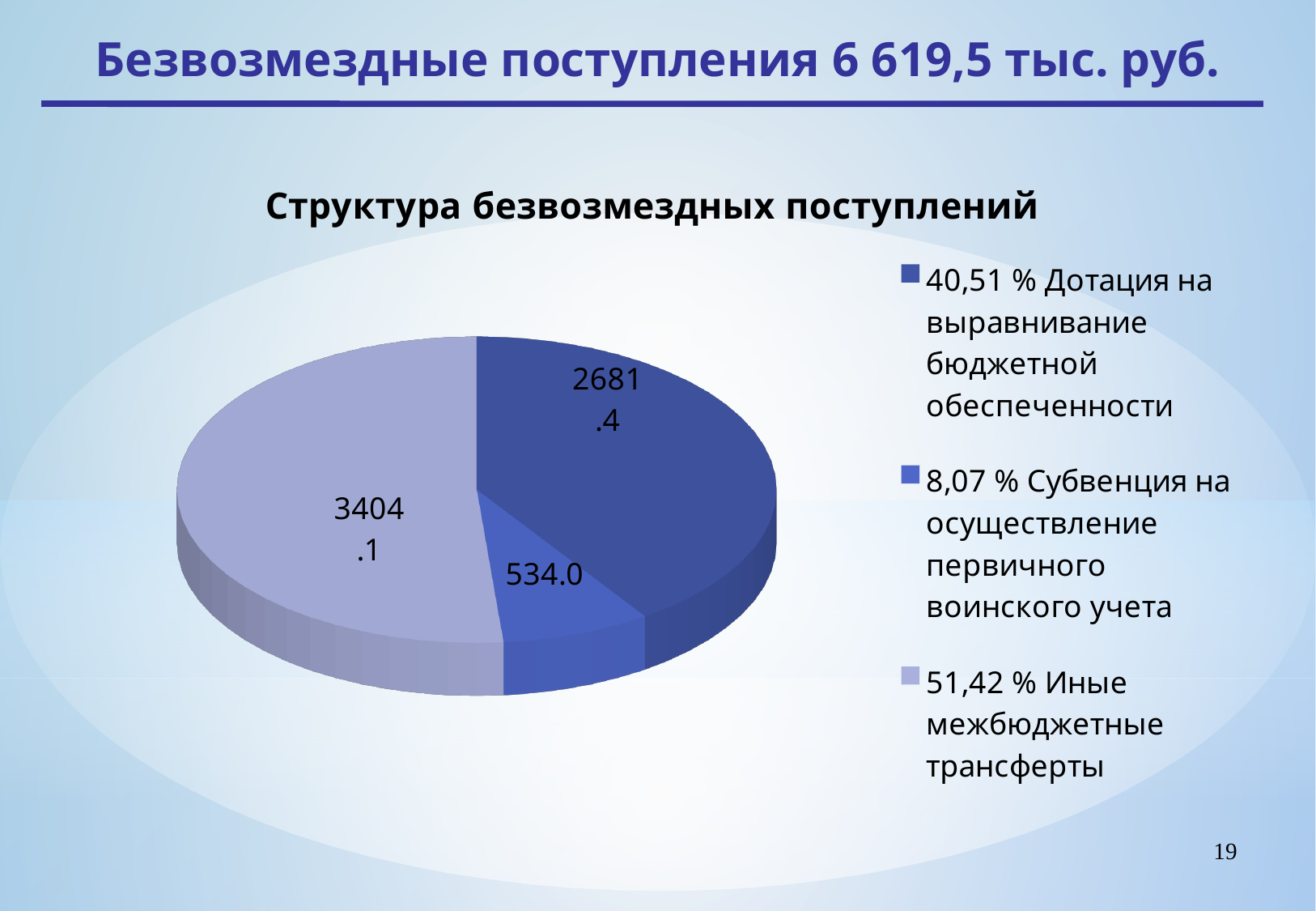
Which category has the smallest slice of the pie? Субвенция на осуществление первичного воинского учета What is the title of the chart? Структура безвозмездных поступлений Which is larger: the value for 'Дотация на выравнивание бюджетной обеспеченности' or the value for 'Субвенция на осуществление первичного воинского учета'? Дотация на выравнивание бюджетной обеспеченности What type of chart is shown on the slide? Pie chart What is the difference between the values for 'Иные межбюджетные трансферты' and 'Дотация на выравнивание бюджетной обеспеченности'? 722.7 What is the value shown for the slice 'Субвенция на осуществление первичного воинского учета'? 534.0 What share of the pie does 'Субвенция на осуществление первичного воинского учета' represent, according to the legend? 8,07 % What is the value shown for the slice 'Дотация на выравнивание бюджетной обеспеченности'? 2681.4 Which category has the largest slice of the pie? Иные межбюджетные трансферты What share of the pie does 'Иные межбюджетные трансферты' represent, according to the legend? 51,42 % What is the value shown for the slice 'Иные межбюджетные трансферты'? 3404.1 How many slices does the pie chart have? 3